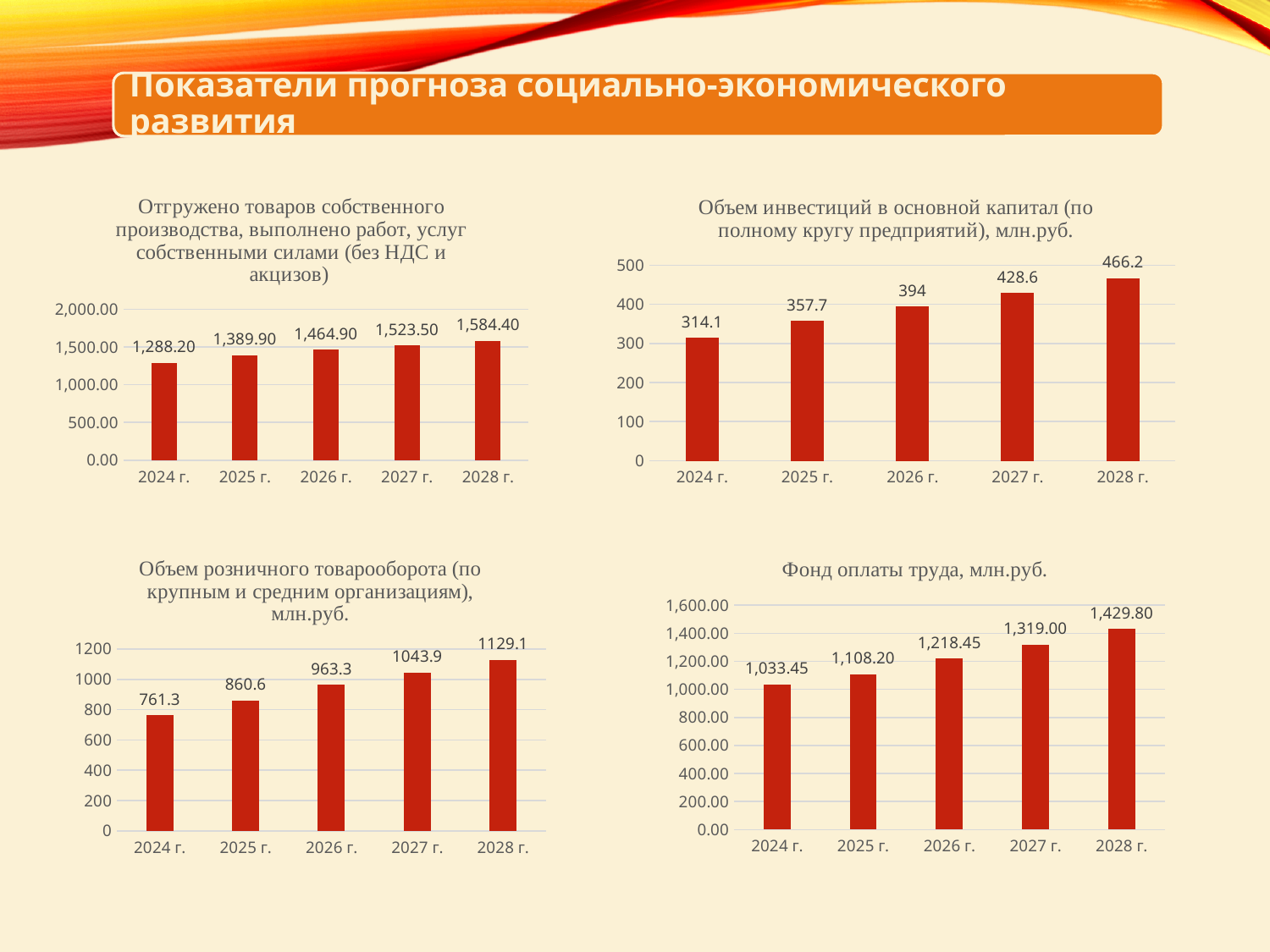
In the bottom-right chart (Фонд оплаты труда), what is the value for 2027 г.? 1,319.00 In the top-left chart (Отгружено товаров собственного производства), how many years are shown on the x axis? 5 In the bottom-right chart (Фонд оплаты труда), what is the difference between the values for 2028 г. and 2027 г.? 110.80 In the top-right chart (Объем инвестиций в основной капитал), which year has the highest value? 2028 г. What kind of chart is the bottom-right chart (Фонд оплаты труда)? bar chart In the bottom-left chart (Объем розничного товарооборота), what is the value for 2024 г.? 761.3 In the bottom-left chart (Объем розничного товарооборота), which is larger: the value for 2026 г. or 2027 г.? 2027 г. In the top-right chart (Объем инвестиций в основной капитал), what is the difference between the values for 2028 г. and 2024 г.? 152.1 In the top-right chart (Объем инвестиций в основной капитал), what is the value for 2026 г.? 394 In the bottom-left chart (Объем розничного товарооборота), which year has the lowest value? 2024 г. In the top-left chart (Отгружено товаров собственного производства), what is the value for 2028 г.? 1,584.40 In the bottom-right chart (Фонд оплаты труда), do the values rise or fall from 2024 г. to 2028 г.? rise